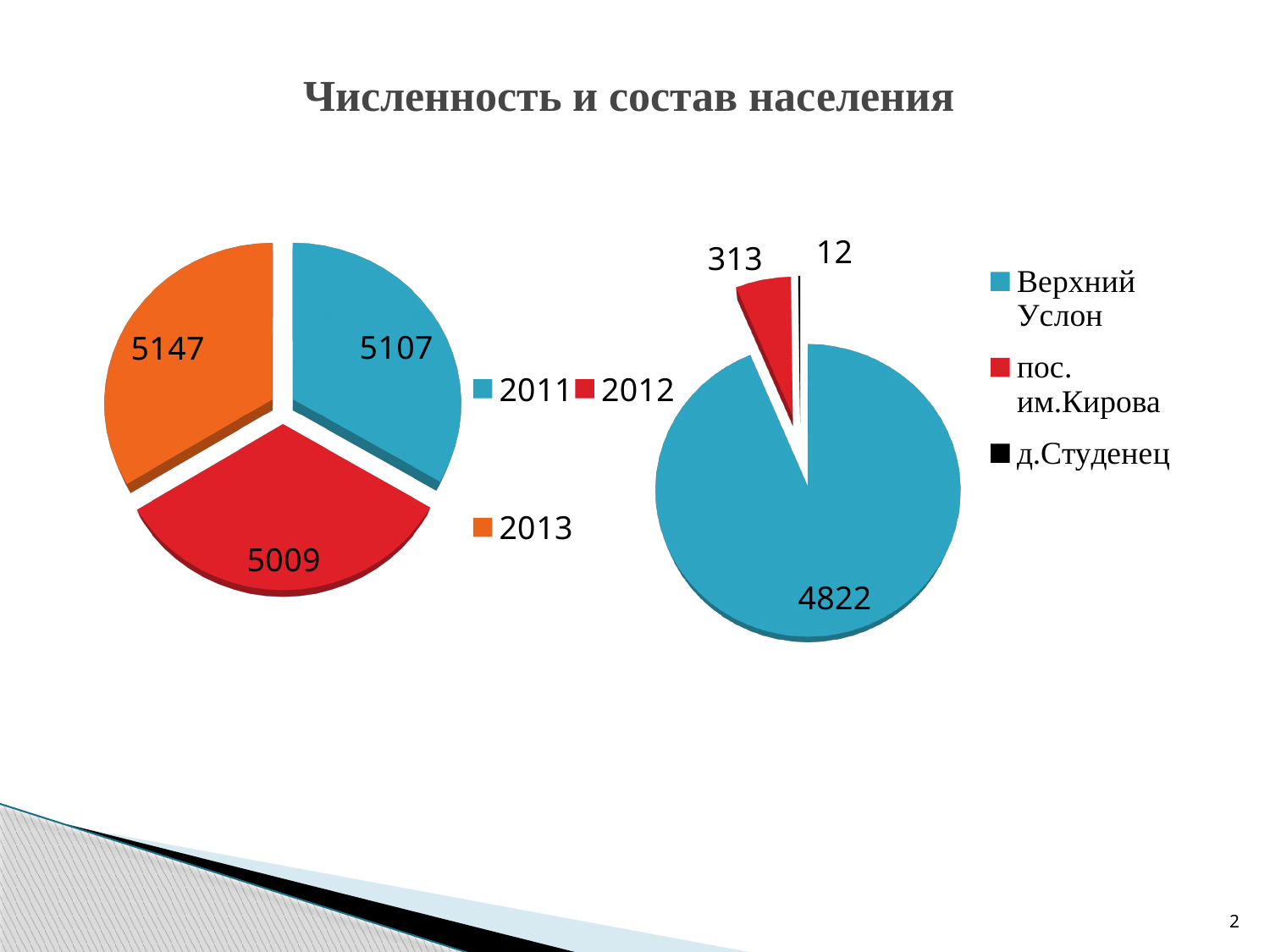
How many slices does the right pie chart have? 3 In the right pie chart, which category has the largest slice? Верхний Услон In the right pie chart, what is the value for д.Студенец? 12 In the left pie chart, which year has the lowest value? 2012 What is the title of the slide? Численность и состав населения In the left pie chart, what is the value for 2013? 5147 In the right pie chart, what is the difference between the values for пос. им.Кирова and д.Студенец? 301 In the left pie chart, what is the value for 2011? 5107 In the left pie chart, what is the difference between the values for 2013 and 2012? 138 What type of chart is the left chart on the slide? Pie chart In the left pie chart, which is larger, the value for 2011 or the value for 2012? 2011 In the right pie chart, what is the value for пос. им.Кирова? 313